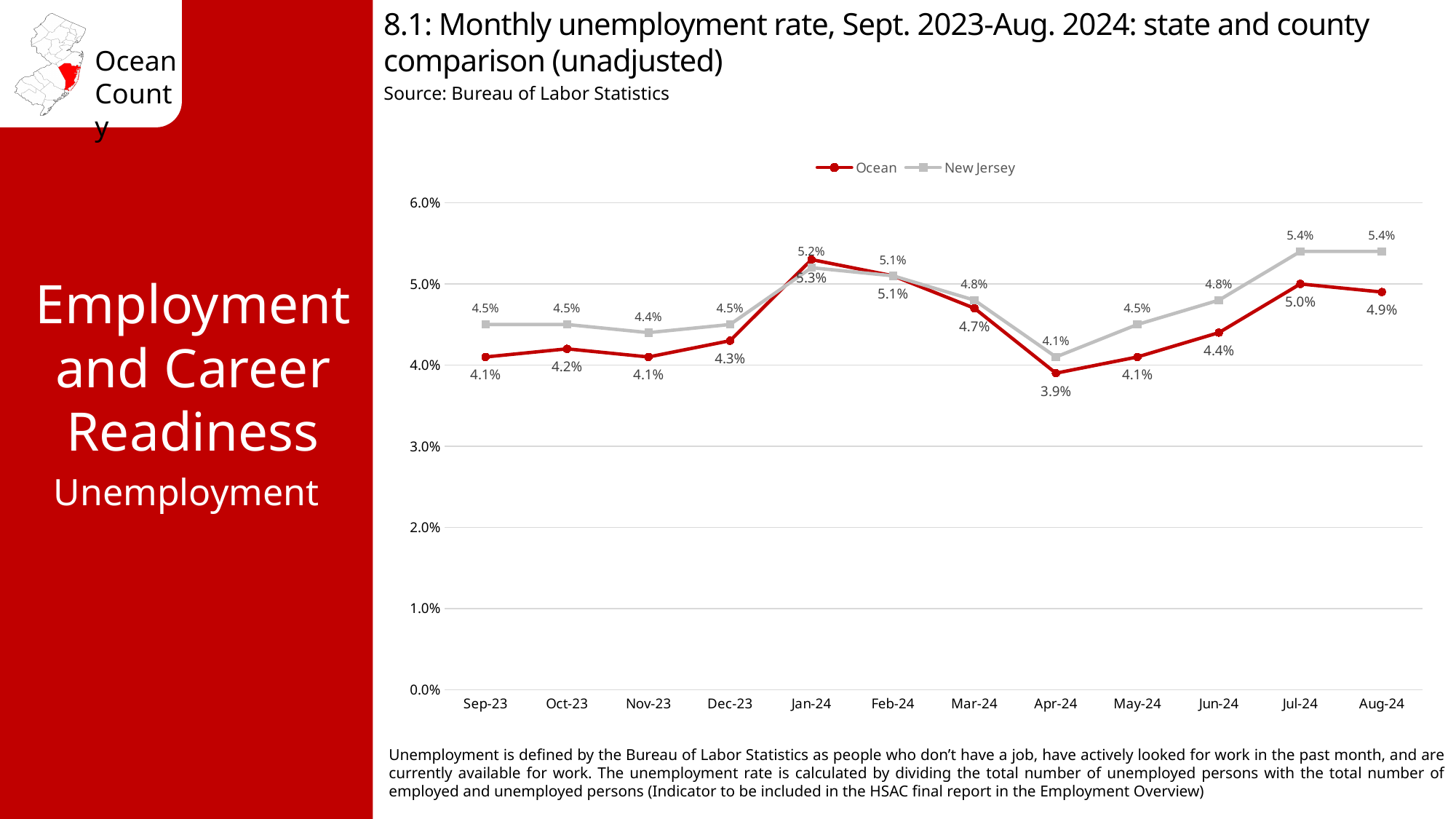
In which month was Ocean County's unemployment rate lowest? Apr-24 What kind of chart is this? Line chart Which had the higher unemployment rate in Jan-24, Ocean or New Jersey? Ocean Which had the higher unemployment rate in Jun-24, Ocean or New Jersey? New Jersey What was Ocean County's unemployment rate in Jan-24? 5.3% How many series does the legend list? 2 How many months are shown on the x axis? 12 What was Ocean County's unemployment rate in Apr-24? 3.9% Did Ocean County's unemployment rate rise or fall from Apr-24 to Jul-24? Rise In which month was Ocean County's unemployment rate highest? Jan-24 What was New Jersey's unemployment rate in Jul-24? 5.4% What is the difference between New Jersey's and Ocean County's unemployment rates in Aug-24? 0.5%